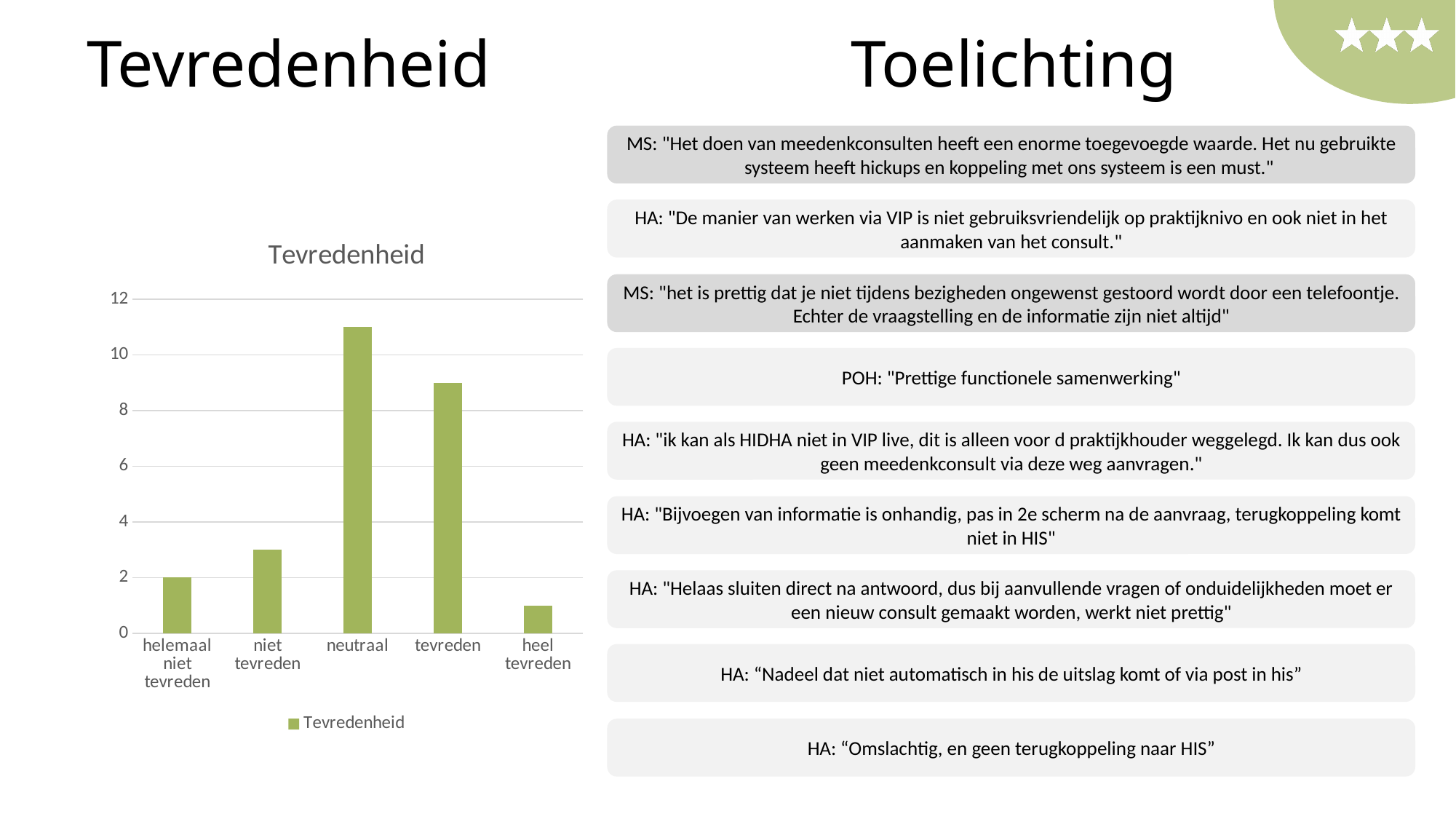
Is the value for 'neutraal' greater or less than 10? greater How many series does the chart legend list? 1 Do the values rise or fall from 'neutraal' to 'heel tevreden'? fall What kind of chart is shown on the slide? bar chart Which category has the lowest bar in the chart? heel tevreden How many categories are shown on the x axis of the chart? 5 What is the title of the chart? Tevredenheid What is the value for 'helemaal niet tevreden'? 2 Is the value for 'heel tevreden' greater or less than 2? less Which is larger, the value for 'neutraal' or the value for 'tevreden'? neutraal Which category has the highest bar in the chart? neutraal Is the value for 'tevreden' greater or less than 8? greater